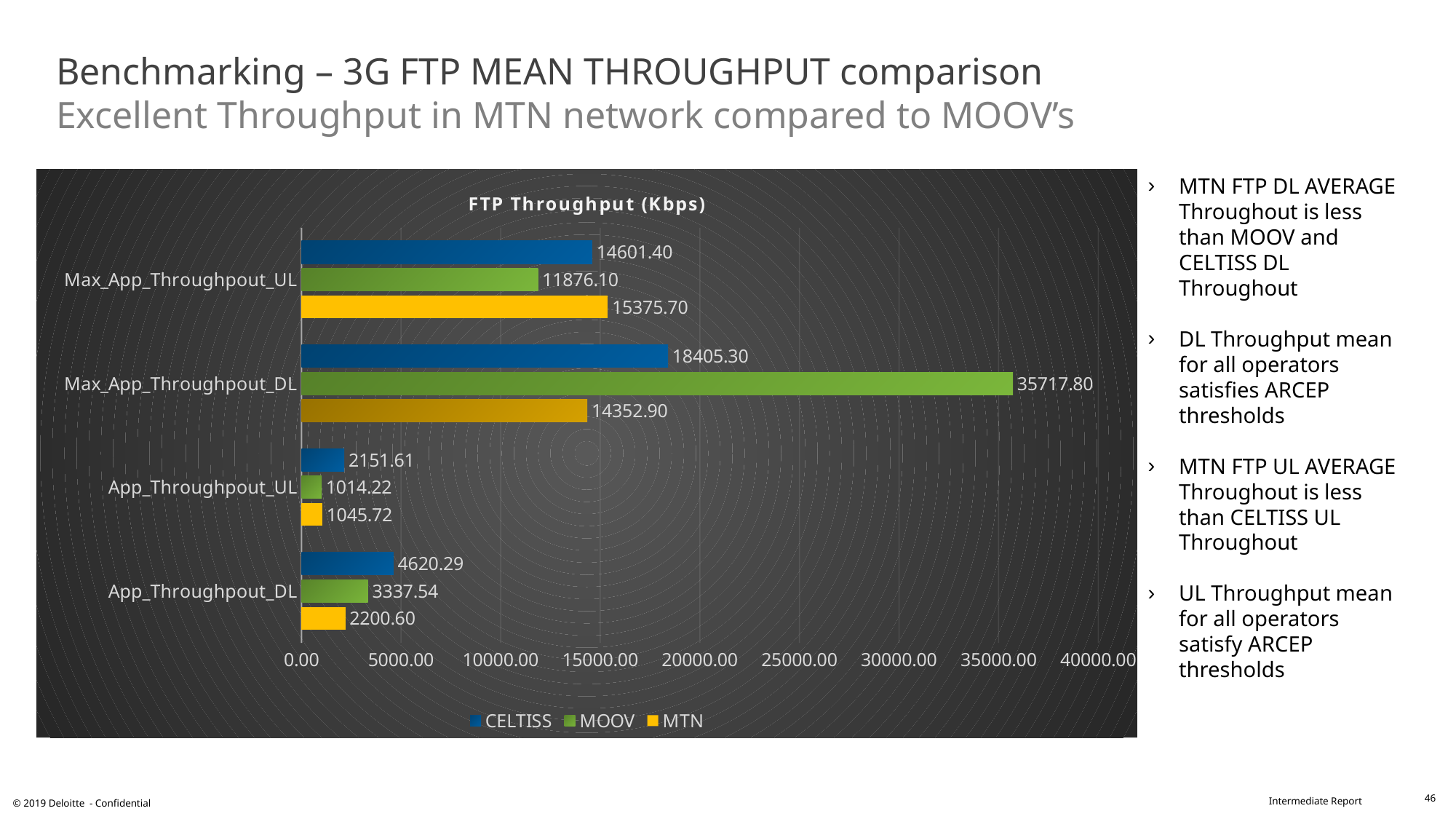
Is the MOOV value for Max_App_Throughpout_DL greater or less than 30000.00? greater How many categories are shown on the y axis of the chart? 4 What is the MOOV value for Max_App_Throughpout_DL? 35717.80 Which operator has the lowest value for App_Throughpout_UL? MOOV What is the difference between the MOOV and CELTISS values for Max_App_Throughpout_DL? 17312.50 What is the CELTISS value for App_Throughpout_UL? 2151.61 Which operator has the highest value for Max_App_Throughpout_DL? MOOV What is the MTN value for Max_App_Throughpout_UL? 15375.70 What is the MTN value for App_Throughpout_DL? 2200.60 How many series does the legend list? 3 What type of chart is shown on the slide? Bar chart For App_Throughpout_DL, which is larger: the CELTISS value or the MOOV value? CELTISS